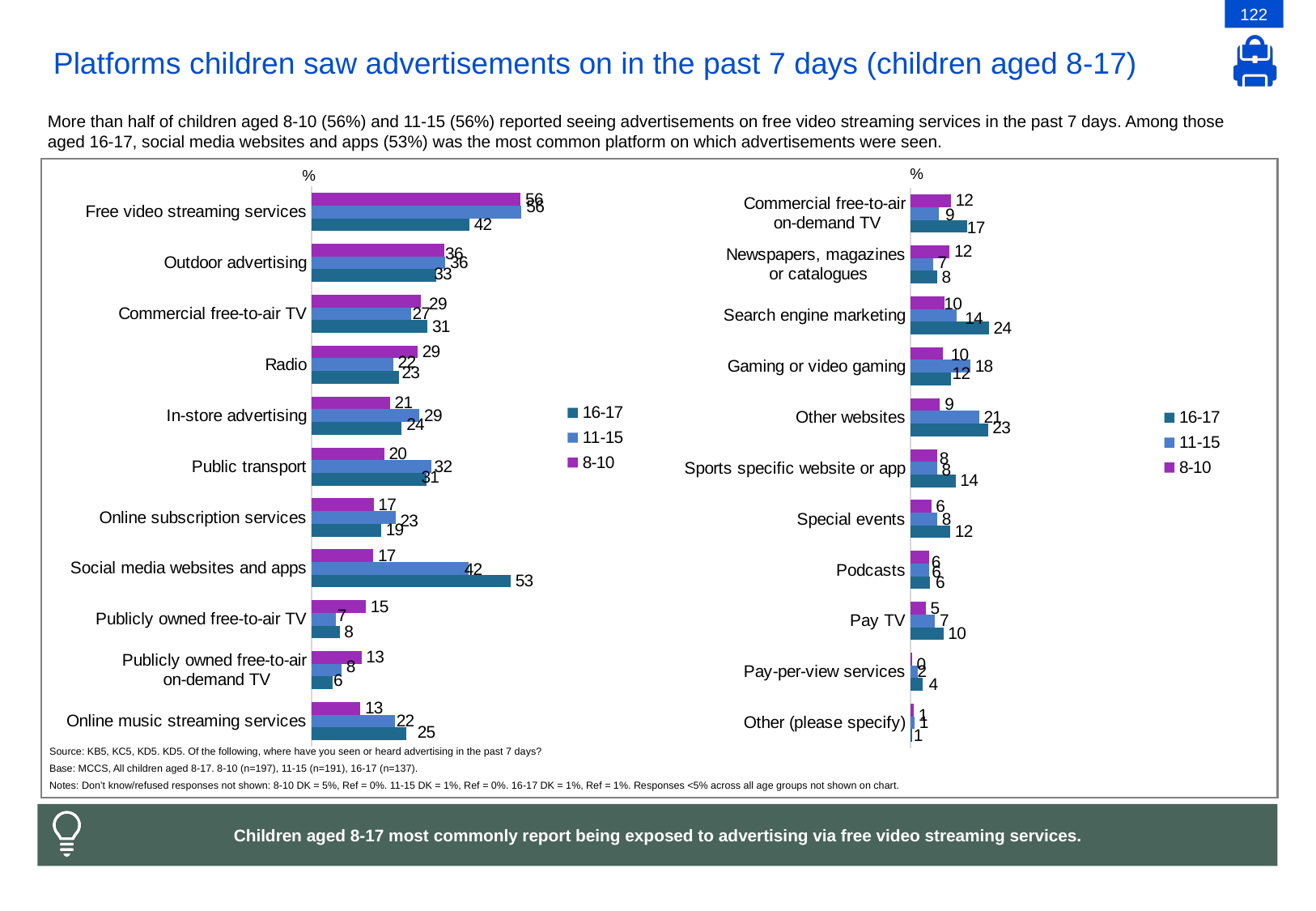
On the left chart, what percentage of children aged 16-17 saw advertisements on social media websites and apps? 53 On the left chart, what is the value for children aged 8-10 for free video streaming services? 56 On the right chart, what is the total of the three age-group values for podcasts? 18 On the right chart, what is the value for children aged 11-15 for gaming or video gaming? 18 On the left chart, which platform has the highest value for children aged 16-17? Social media websites and apps How many platforms are listed on the left chart? 11 On the right chart, what is the value for children aged 16-17 for search engine marketing? 24 What type of chart is used on the left side of the slide? Bar chart How many series does the legend of the right chart list? 3 On the right chart, which platform has the lowest value for children aged 16-17? Other (please specify) On the left chart, what is the difference between the 16-17 and 8-10 values for social media websites and apps? 36 On the right chart, which is larger for other websites: the value for 11-15 or the value for 16-17? 16-17